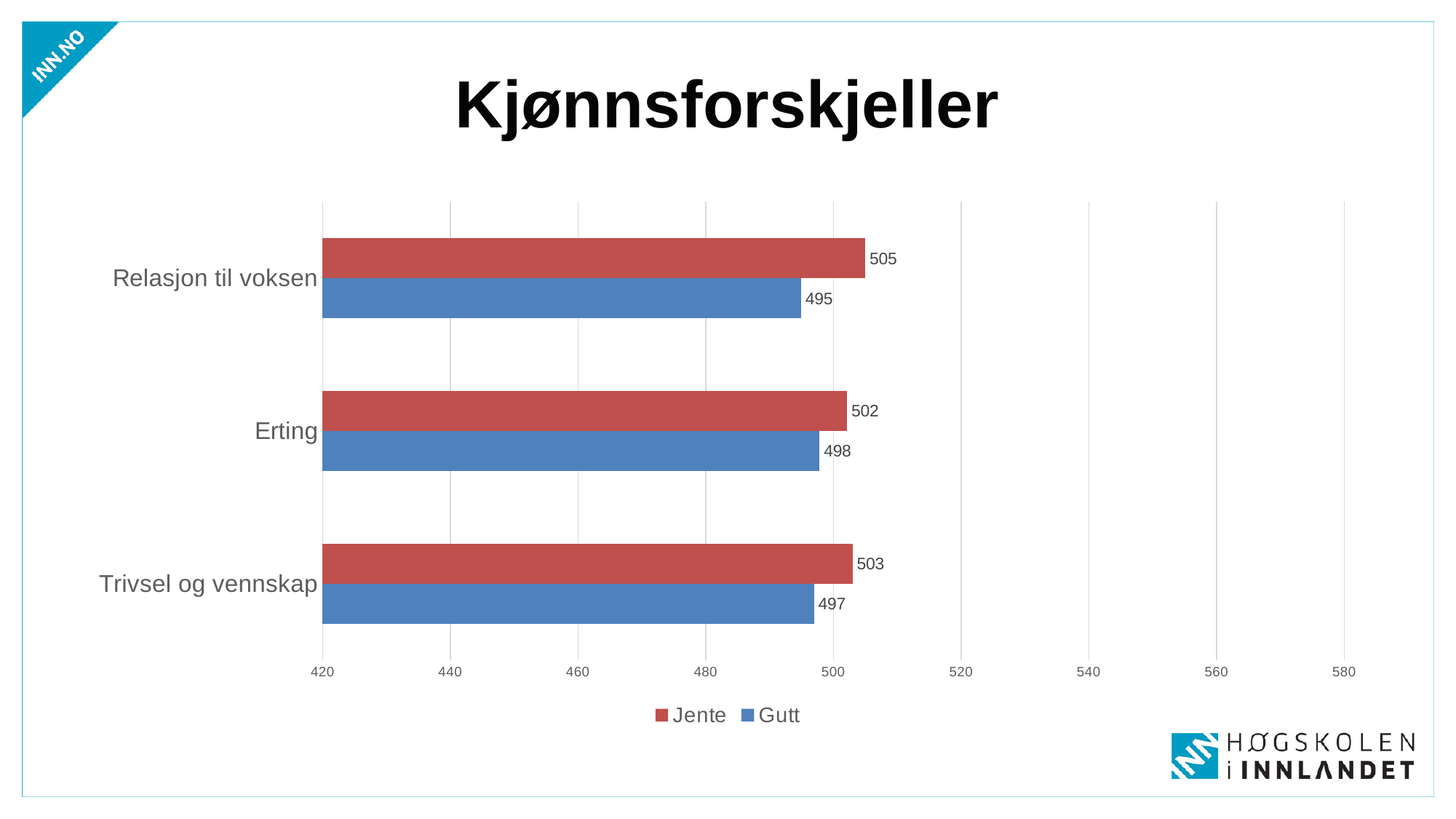
How many categories are shown on the chart? 3 Is the Gutt value for Relasjon til voksen greater or less than 500? less What kind of chart is shown on the slide? Bar chart What is the value for Jente in the Erting category? 502 How many series does the legend list? 2 What is the value for Gutt in the Trivsel og vennskap category? 497 Which is larger for Trivsel og vennskap, the Jente value or the Gutt value? Jente Which category has the lowest Gutt value? Relasjon til voksen What is the value for Gutt in the Erting category? 498 Which category has the highest Jente value? Relasjon til voksen What is the value for Jente in the Relasjon til voksen category? 505 What is the difference between the Jente and Gutt values for Relasjon til voksen? 10